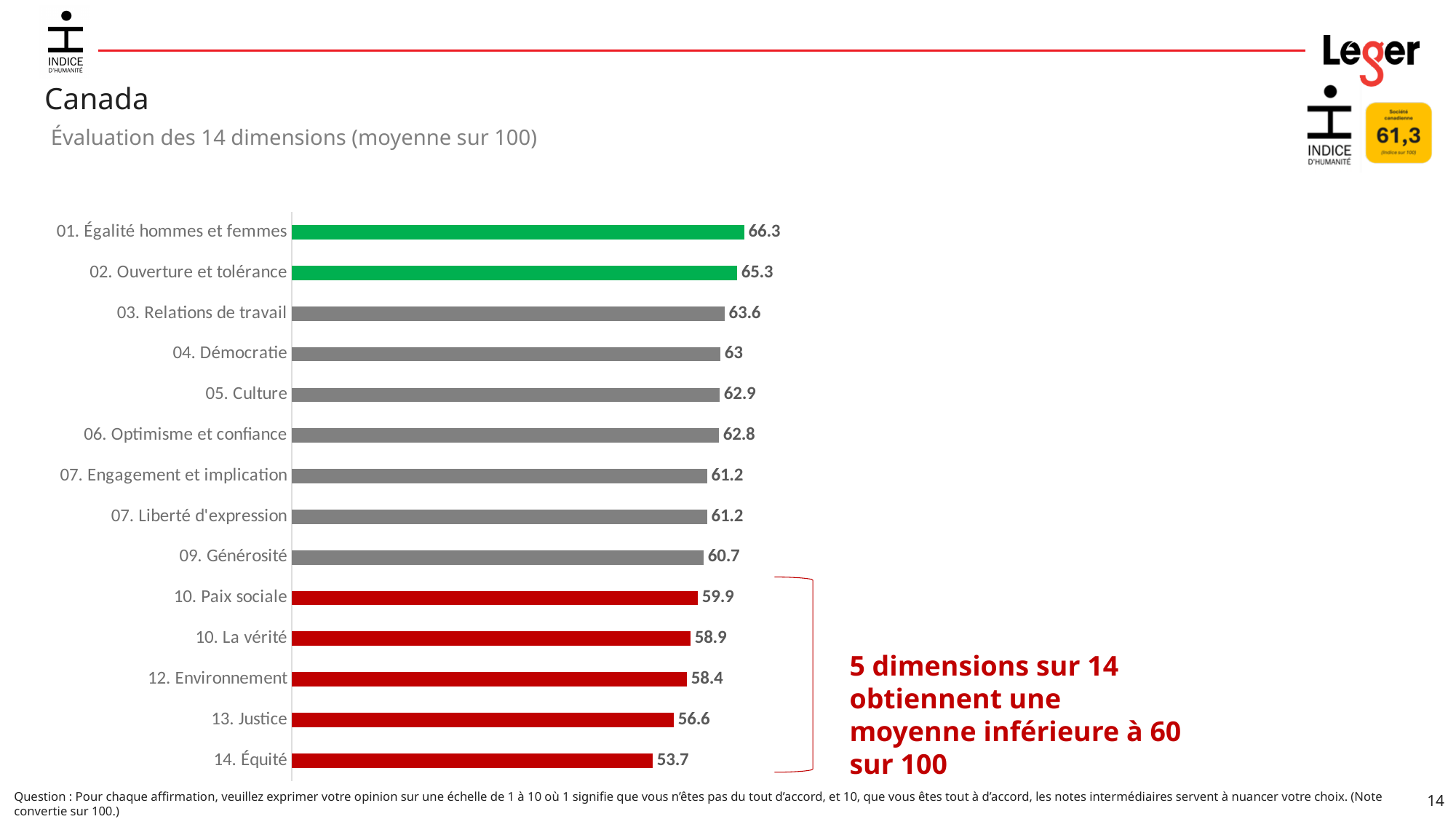
How many dimensions have a value below 60? 5 What is the value for 09. Générosité? 60.7 What kind of chart is shown on the slide? Bar chart Which dimension has the highest value? 01. Égalité hommes et femmes What colour are the bars for the dimensions with a value below 60? Red What is the difference between the values for 03. Relations de travail and 13. Justice? 7 What is the difference between the values for 01. Égalité hommes et femmes and 14. Équité? 12.6 Which is larger, the value for 05. Culture or the value for 10. Paix sociale? 05. Culture What is the value for 12. Environnement? 58.4 What is the value for 01. Égalité hommes et femmes? 66.3 Which dimension has the lowest value? 14. Équité How many dimensions are plotted in the chart? 14